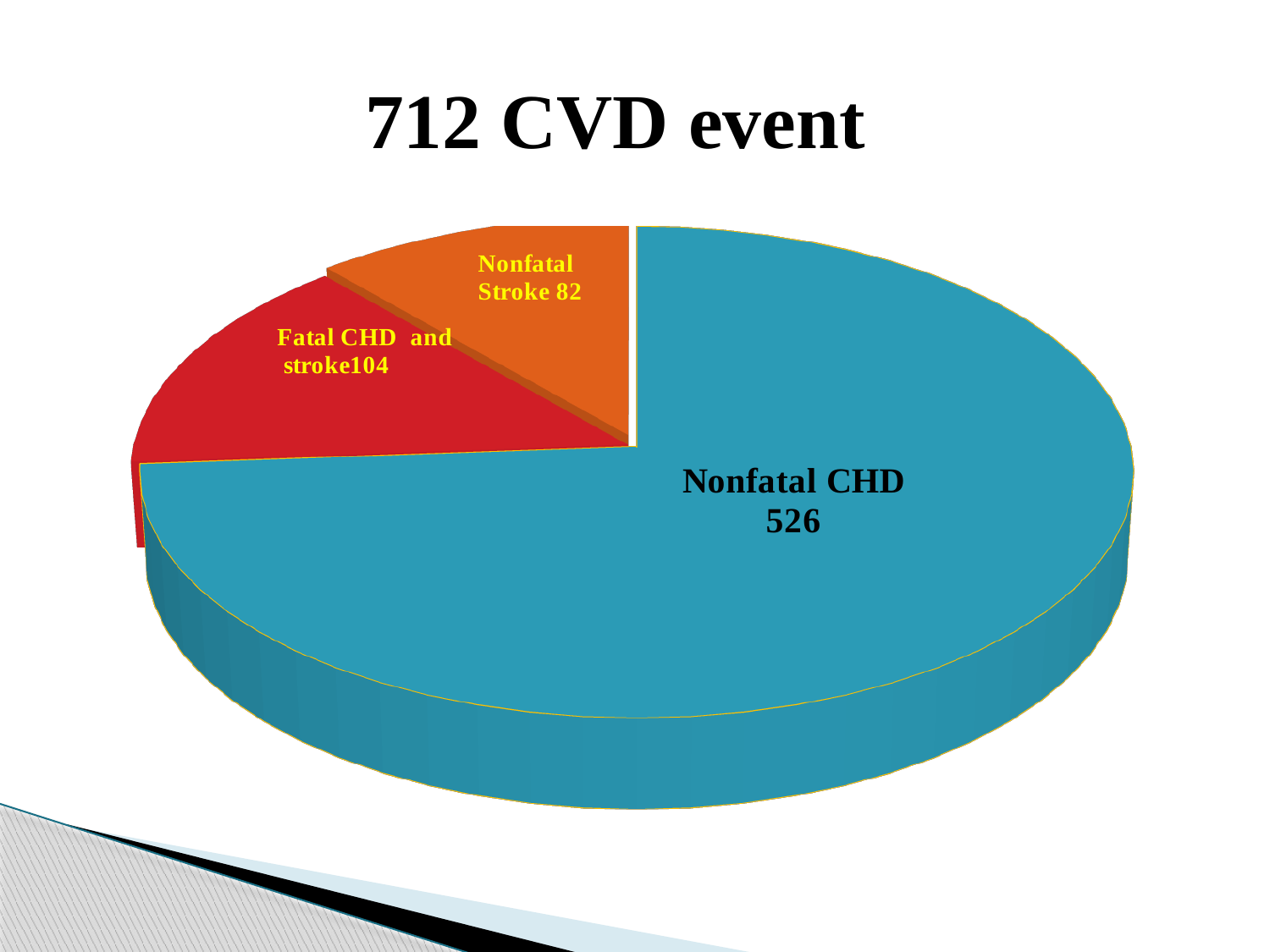
Which is larger, Fatal CHD and stroke or Nonfatal Stroke? Fatal CHD and stroke What kind of chart is shown on the slide? Pie chart What is the value for Nonfatal Stroke? 82 Which category has the largest slice of the pie? Nonfatal CHD How many slices does the pie chart have? 3 What is the difference between the Nonfatal CHD value and the Fatal CHD and stroke value? 422 What is the total of all the slices in the pie chart? 712 What is the value for Fatal CHD and stroke? 104 What is the title of the chart? 712 CVD event What is the value for Nonfatal CHD? 526 What is the difference between the Fatal CHD and stroke value and the Nonfatal Stroke value? 22 Which category has the smallest slice of the pie? Nonfatal Stroke